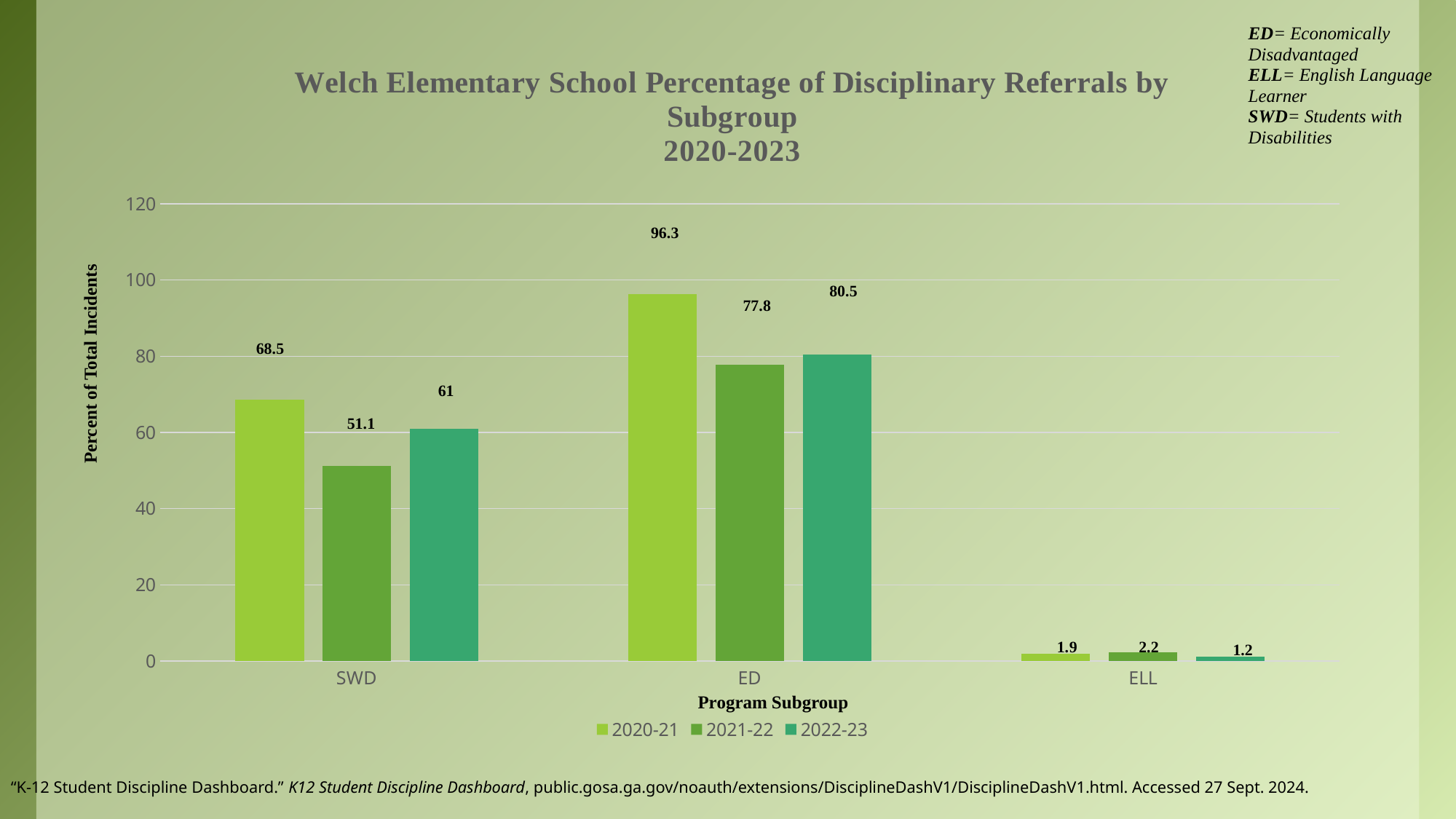
What is the value for ELL in 2022-23? 1.2 Which subgroup has the highest value in 2022-23? ED What is the difference between the 2020-21 and 2022-23 values for ED? 15.8 How many program subgroups are shown on the x axis? 3 What kind of chart is shown on the slide? Bar chart How many series does the legend list? 3 What is the value for SWD in 2021-22? 51.1 What is the value for ED in 2020-21? 96.3 What is the label of the y axis? Percent of Total Incidents Which is larger for ELL: the 2021-22 value or the 2022-23 value? 2021-22 What is the difference between the 2020-21 and 2021-22 values for SWD? 17.4 Which subgroup has the lowest value in 2020-21? ELL